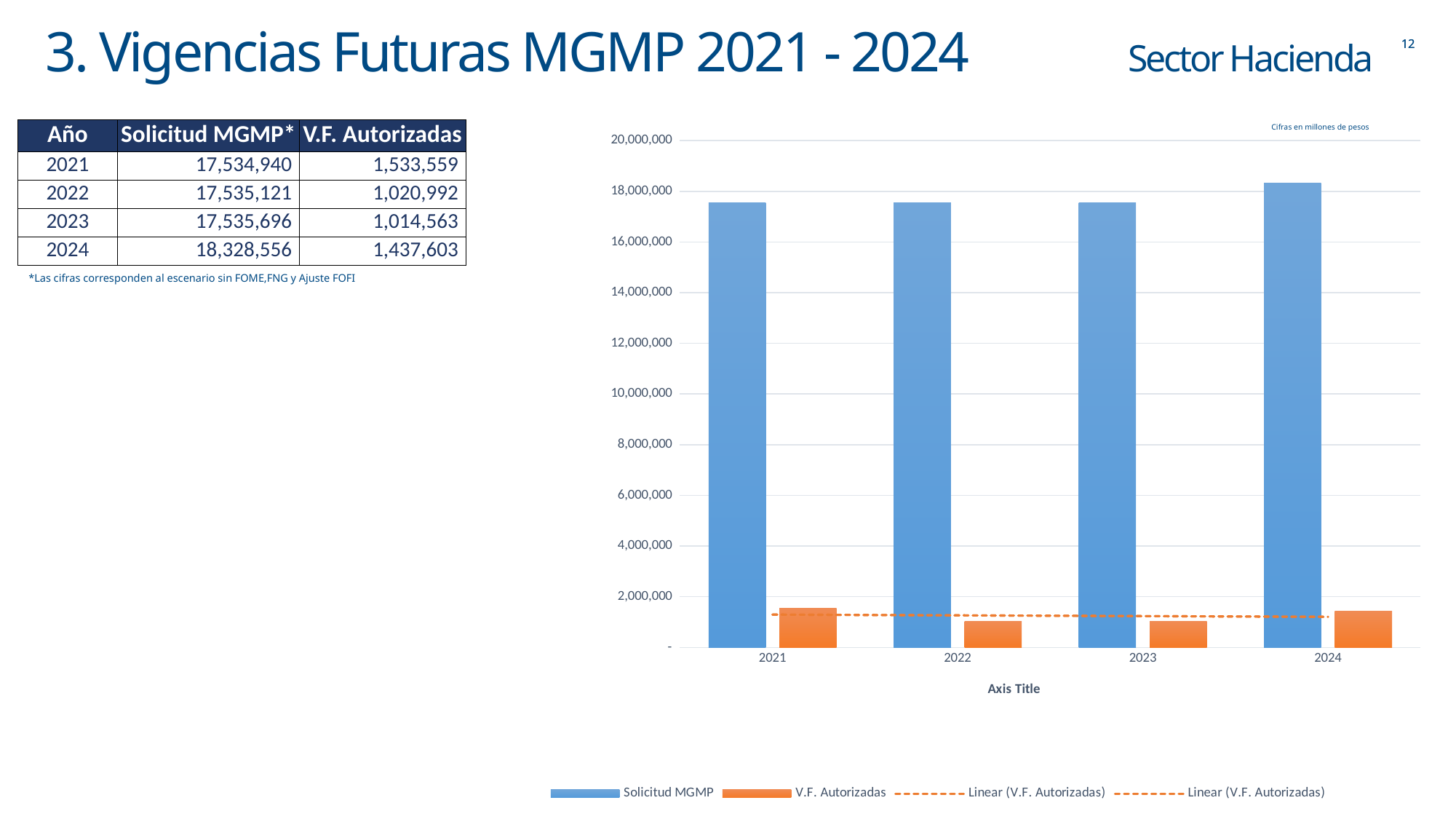
What is the Solicitud MGMP value for 2024? 18,328,556 What is the V.F. Autorizadas value for 2023? 1,014,563 Is the V.F. Autorizadas value for 2022 greater or less than 2,000,000? less What kind of chart is shown on the slide? Bar chart How many entries does the chart legend list? 4 Is the Solicitud MGMP value for 2021 greater or less than 16,000,000? greater What is the V.F. Autorizadas value for 2021? 1,533,559 In which year is the V.F. Autorizadas value the highest? 2021 How many years are shown on the x axis of the chart? 4 Which is larger, the V.F. Autorizadas value for 2021 or for 2024? 2021 What is the difference between the Solicitud MGMP values for 2024 and 2021? 793,616 In which year is the Solicitud MGMP bar the highest? 2024